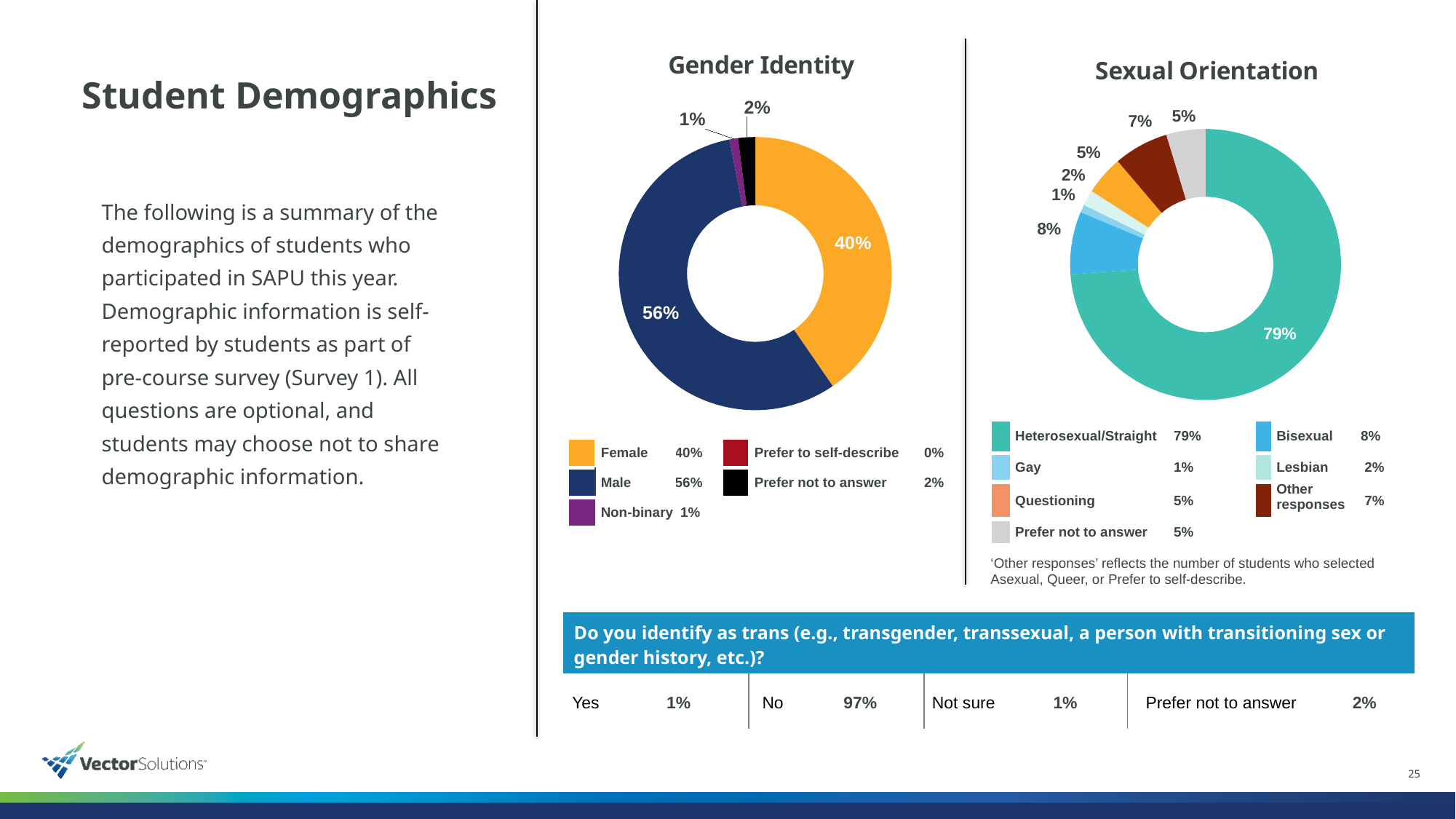
How many categories does the Sexual Orientation chart's legend list? 7 In the Sexual Orientation chart, which is larger: Other responses or Questioning? Other responses In the Sexual Orientation chart, what is the difference between the Bisexual and Lesbian shares? 6% In the Gender Identity chart, what is the difference between the Male and Female shares? 16% In the Gender Identity chart, what percentage of students identified as Male? 56% In the Sexual Orientation chart, which category has the smallest share? Gay What kind of chart is the Gender Identity chart? Pie (donut) chart In the Gender Identity chart, which category has the largest share? Male In the Sexual Orientation chart, what percentage of students identified as Heterosexual/Straight? 79% In the Sexual Orientation chart, what percentage of students identified as Bisexual? 8% How many categories does the Gender Identity chart's legend list? 5 In the Gender Identity chart, what percentage of students identified as Female? 40%